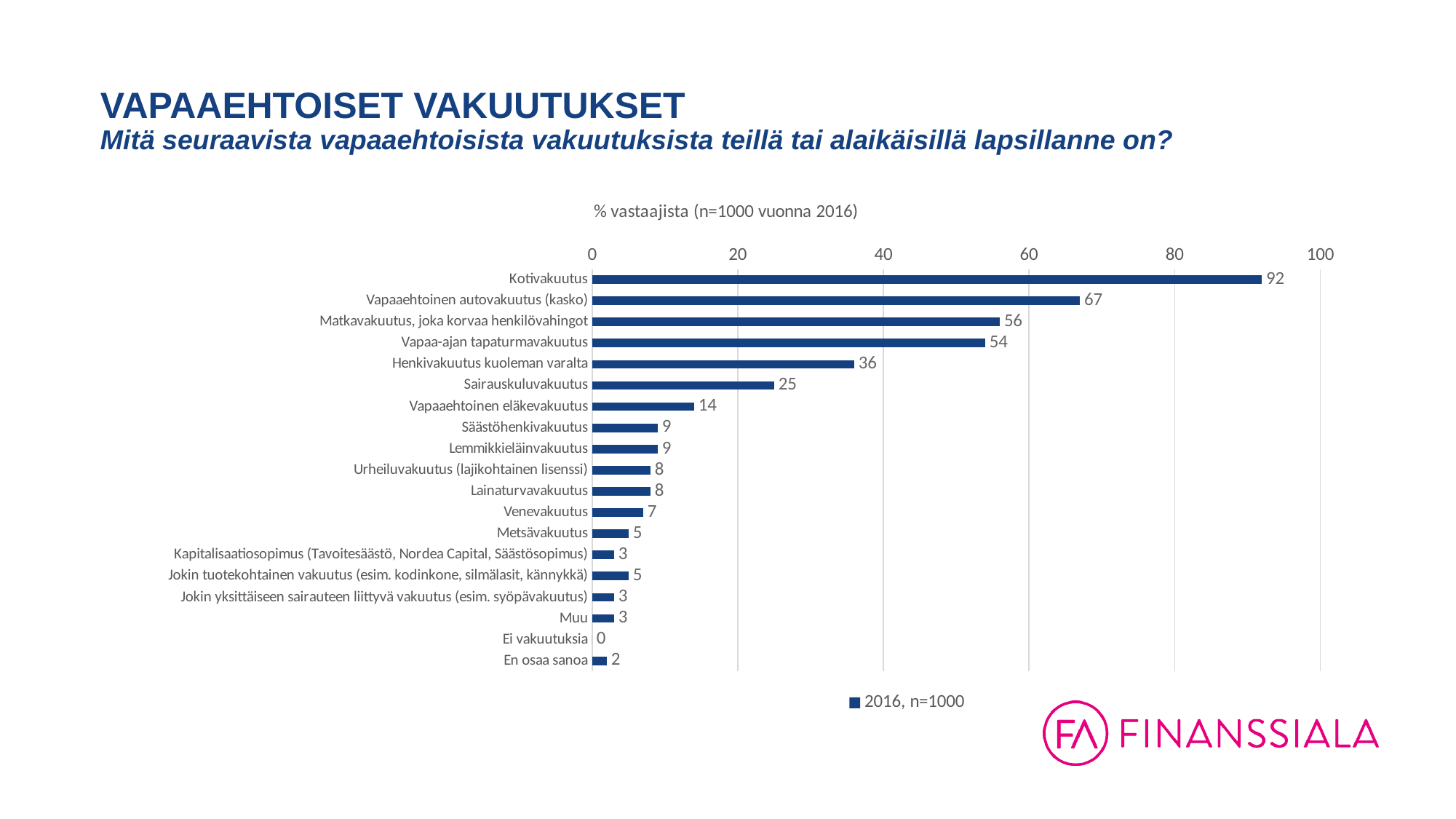
Which category has the highest value? Kotivakuutus What is the value for Vapaaehtoinen autovakuutus (kasko)? 67 What kind of chart is shown on the slide? Bar chart What is the value for Kotivakuutus? 92 What is the value for Sairauskuluvakuutus? 25 What is the difference between the values for Kotivakuutus and Vapaaehtoinen autovakuutus (kasko)? 25 What is the legend entry for the series shown in the chart? 2016, n=1000 How many series does the legend list? 1 Which is larger, the value for Matkavakuutus, joka korvaa henkilövahingot or the value for Vapaa-ajan tapaturmavakuutus? Matkavakuutus, joka korvaa henkilövahingot How many categories are shown in the chart? 19 What is the value for Henkivakuutus kuoleman varalta? 36 Which category has the lowest value? Ei vakuutuksia